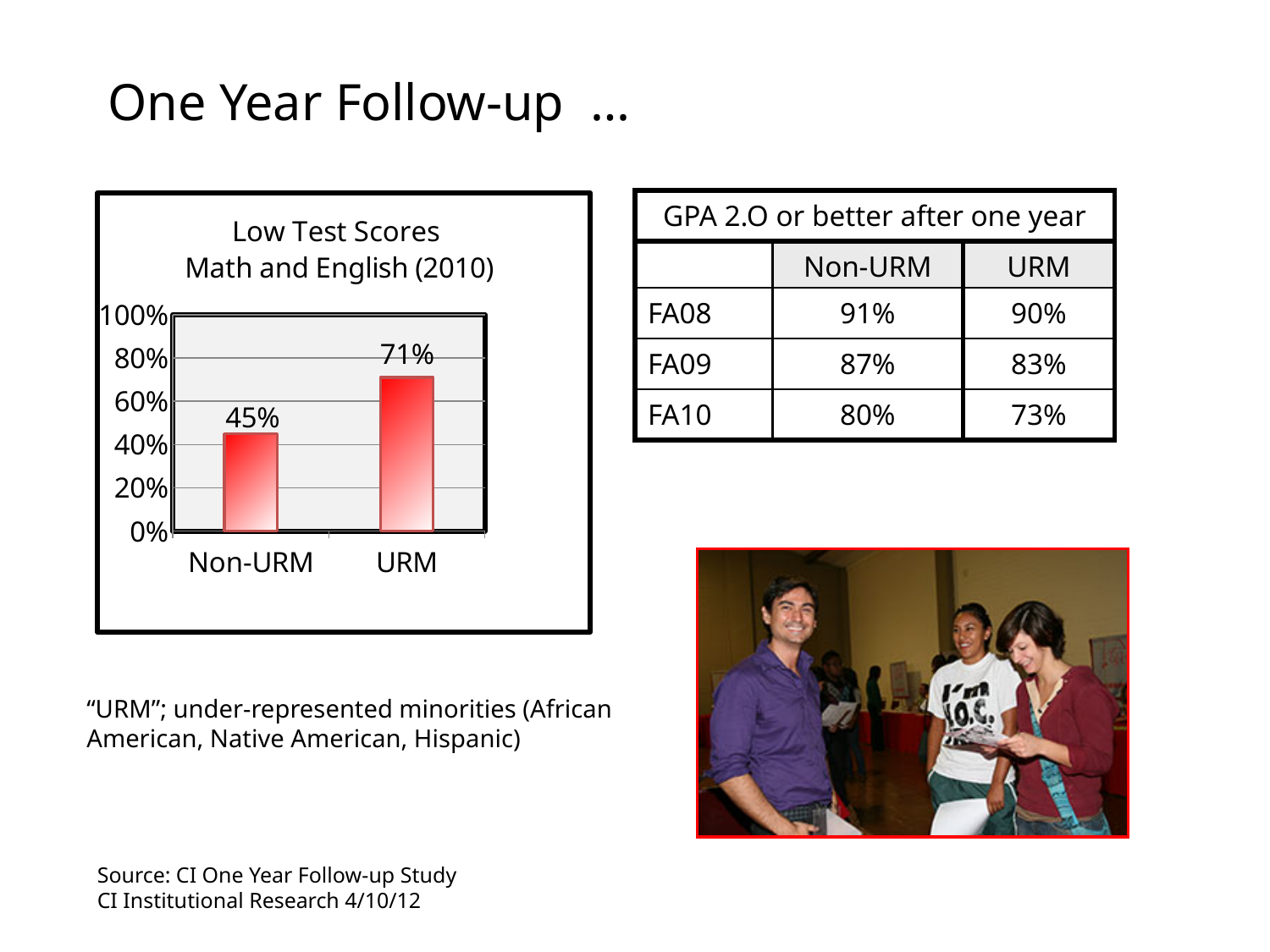
What is the value for Non-URM in the Low Test Scores chart? 45% Is the value for URM in the Low Test Scores chart greater or less than 60%? greater What is the difference between the URM and Non-URM values in the Low Test Scores chart? 26% What is the title of the chart on the slide? Low Test Scores Math and English (2010) What is the value for URM in the Low Test Scores chart? 71% Is the value for Non-URM in the Low Test Scores chart greater or less than 60%? less Which category has the lowest value in the Low Test Scores chart? Non-URM What kind of chart is the Low Test Scores chart? bar chart How many categories are shown in the Low Test Scores chart? 2 What is the maximum value shown on the y axis of the Low Test Scores chart? 100% In the Low Test Scores chart, is the value for URM or Non-URM larger? URM Which category has the highest value in the Low Test Scores chart? URM